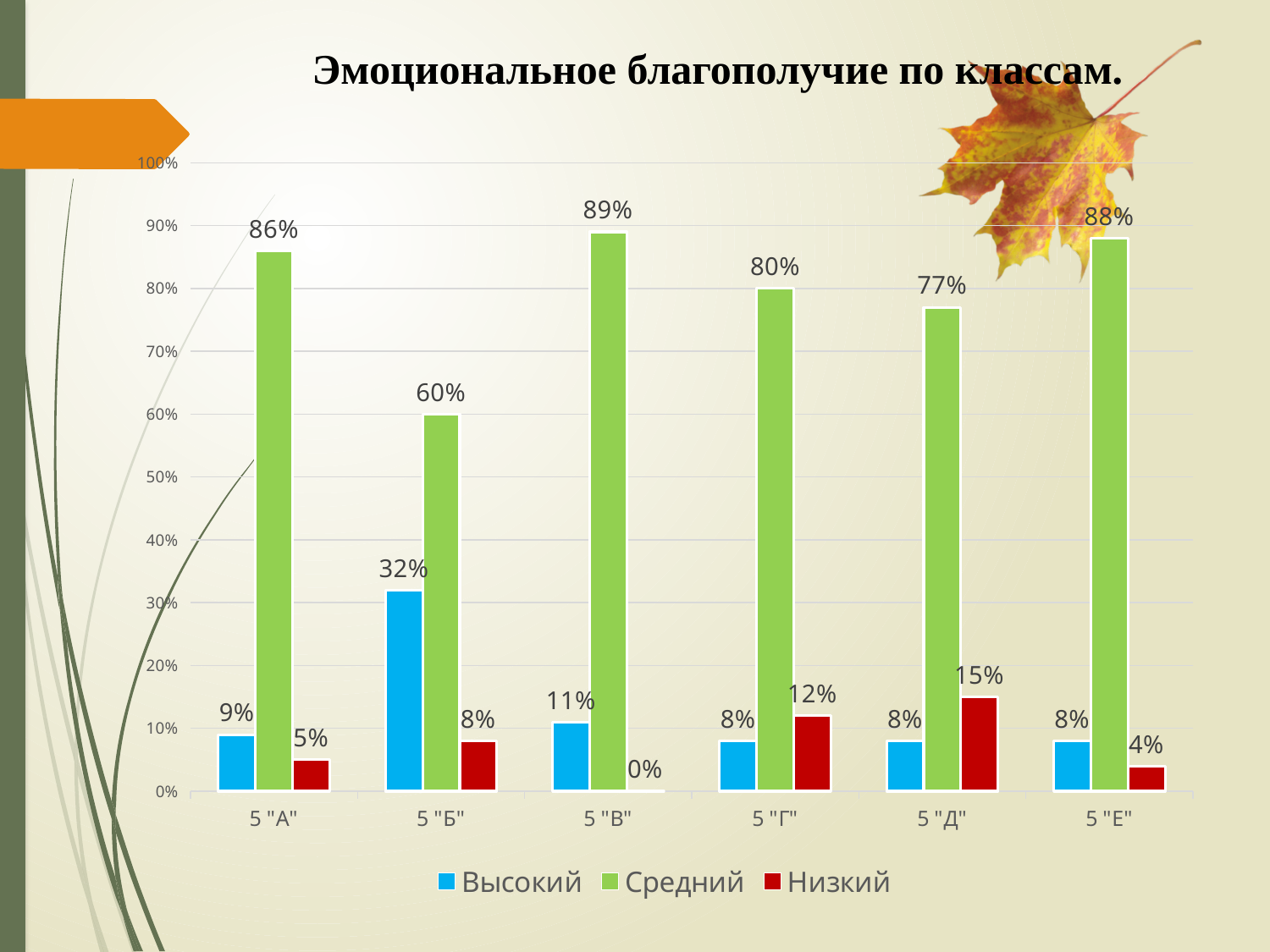
What is the value of Низкий for 5 "Д"? 15% What is the difference between the Средний values for 5 "А" and 5 "Б"? 26% What is the value of Высокий for 5 "Б"? 32% Which class has the highest Средний value? 5 "В" How many series does the legend list? 3 What is the title of the chart? Эмоциональное благополучие по классам. Which is larger: the Низкий value for 5 "Г" or for 5 "Е"? 5 "Г" What kind of chart is shown on the slide? bar chart How many classes are shown on the x axis? 6 What is the value of Средний for 5 "В"? 89% Which class has the lowest Низкий value? 5 "В" Which colour represents the Низкий series? red